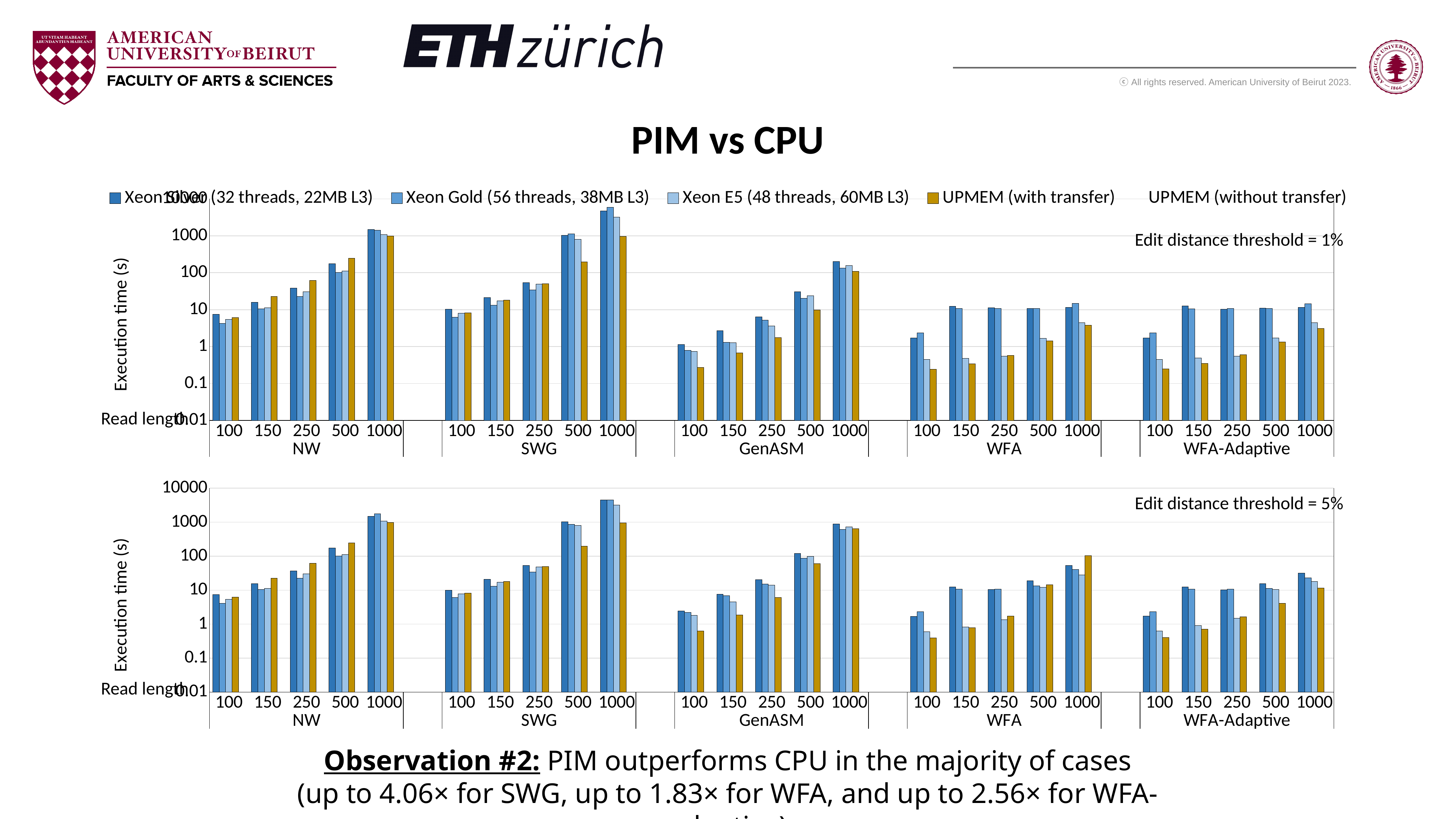
In the top chart (Edit distance threshold = 1%), which read length in the SWG group has the highest Xeon Silver execution time? 1000 In the top chart (Edit distance threshold = 1%), is the UPMEM (with transfer) value for GenASM at read length 100 greater or less than 1? less How many algorithm groups are shown along the x axis of the bottom chart (Edit distance threshold = 5%)? 5 How many series does the legend list? 5 In the bottom chart (Edit distance threshold = 5%), for WFA at read length 1000, which is larger: UPMEM (with transfer) or Xeon Silver? UPMEM (with transfer) In the top chart (Edit distance threshold = 1%), is the Xeon Silver value for SWG at read length 1000 greater or less than 1000? greater In the bottom chart (Edit distance threshold = 5%), is the UPMEM (with transfer) value for SWG at read length 500 greater or less than 100? greater In the top chart (Edit distance threshold = 1%), how many read lengths are plotted for the NW group? 5 What kind of chart is the top chart (Edit distance threshold = 1%)? bar chart In the top chart (Edit distance threshold = 1%), for SWG at read length 500, which is larger: Xeon Silver or UPMEM (with transfer)? Xeon Silver What is the y-axis label of the charts? Execution time (s) In the bottom chart (Edit distance threshold = 5%), does the Xeon Silver execution time for NW rise or fall as read length increases from 100 to 1000? rise